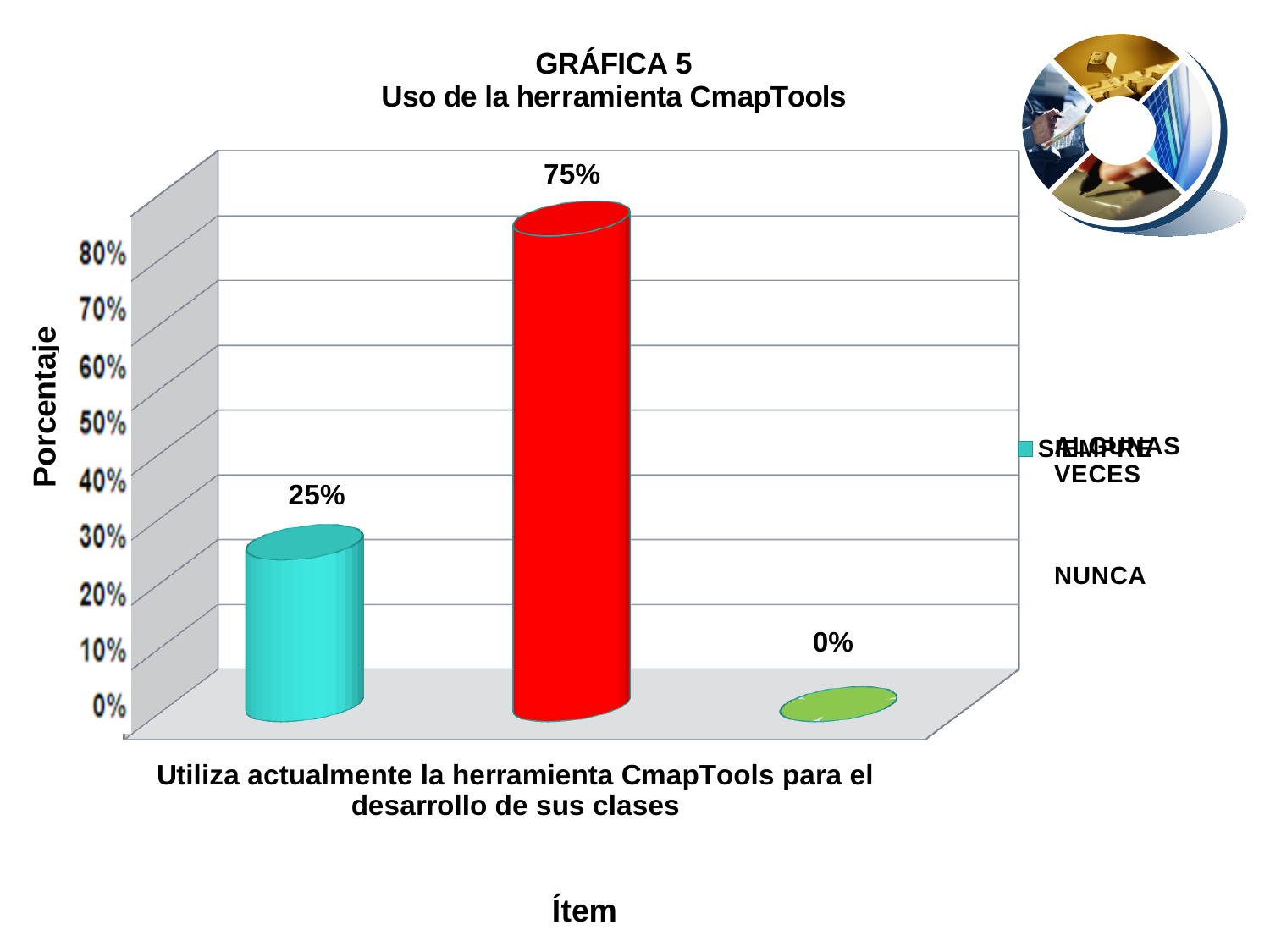
Is the value of the cyan bar greater or less than 30%? less What value is shown for the green bar on the right of the chart? 0% Which bar has the lowest value? The green bar (right), 0% Which is larger, the value of the red bar or the value of the cyan bar? The red bar What value is shown on the red bar in the middle of the chart? 75% What is the difference between the red bar's value and the cyan bar's value? 50 percentage points How many bars are plotted in the chart? 3 What kind of chart is shown on the slide? Bar chart What is the label on the vertical axis of the chart? Porcentaje What is the total of the three values shown on the bars? 100% Which bar has the highest value? The red bar (middle), 75% What value is shown on the cyan bar on the left of the chart? 25%